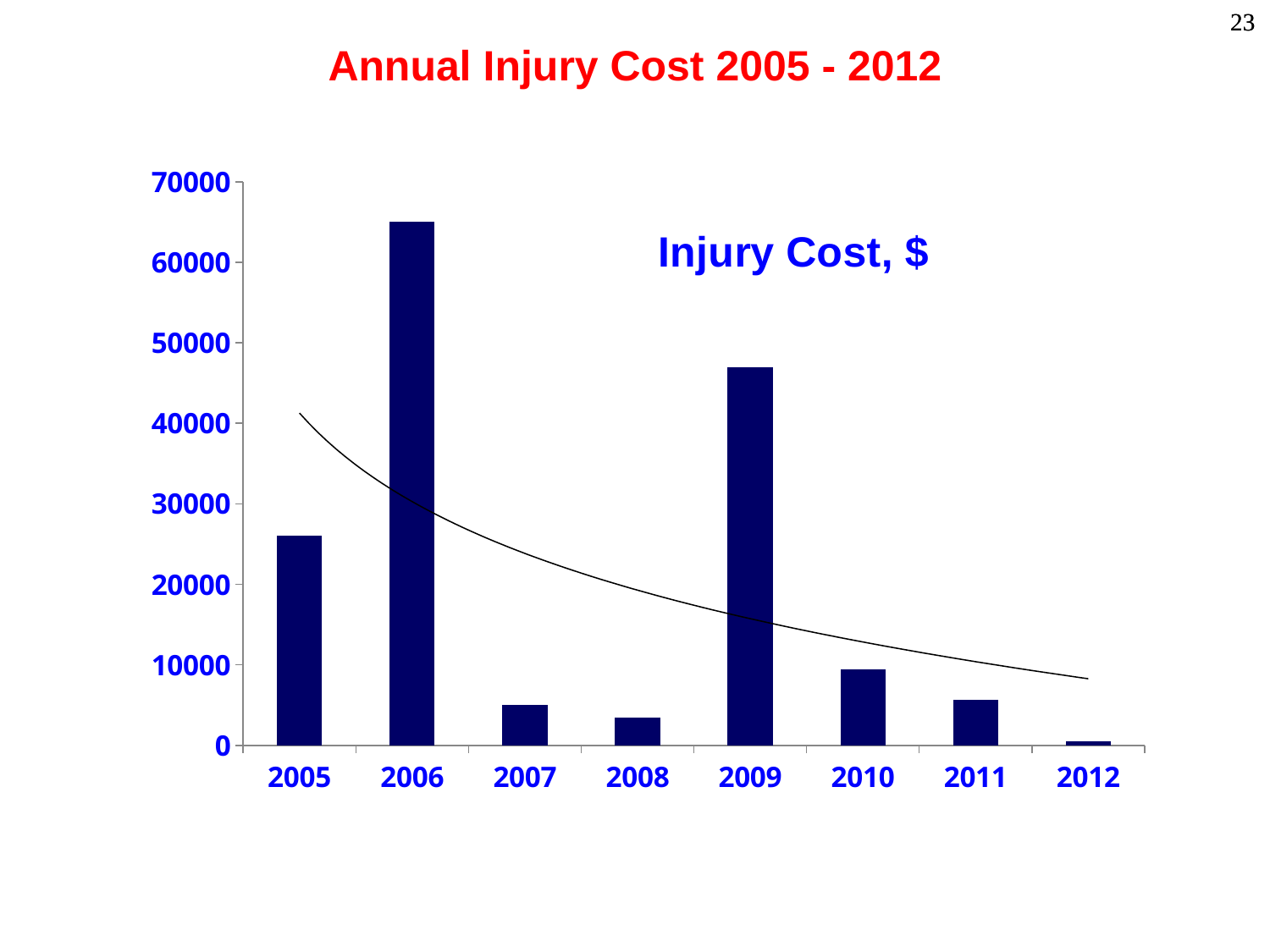
What is the title of the chart? Annual Injury Cost 2005 - 2012 Is the injury cost for 2005 greater or less than 20000? greater Is the injury cost for 2006 greater or less than 60000? greater Which year has the highest injury cost? 2006 Is the injury cost for 2009 greater or less than 50000? less How many years are plotted on the x axis? 8 What kind of chart is shown on the slide? Bar chart Does the trend line drawn across the chart rise or fall from 2005 to 2012? Fall Which year has the lowest injury cost? 2012 Which year has the higher injury cost, 2005 or 2009? 2009 Which year has the higher injury cost, 2008 or 2010? 2010 What series name is shown in the chart legend? Injury Cost, $